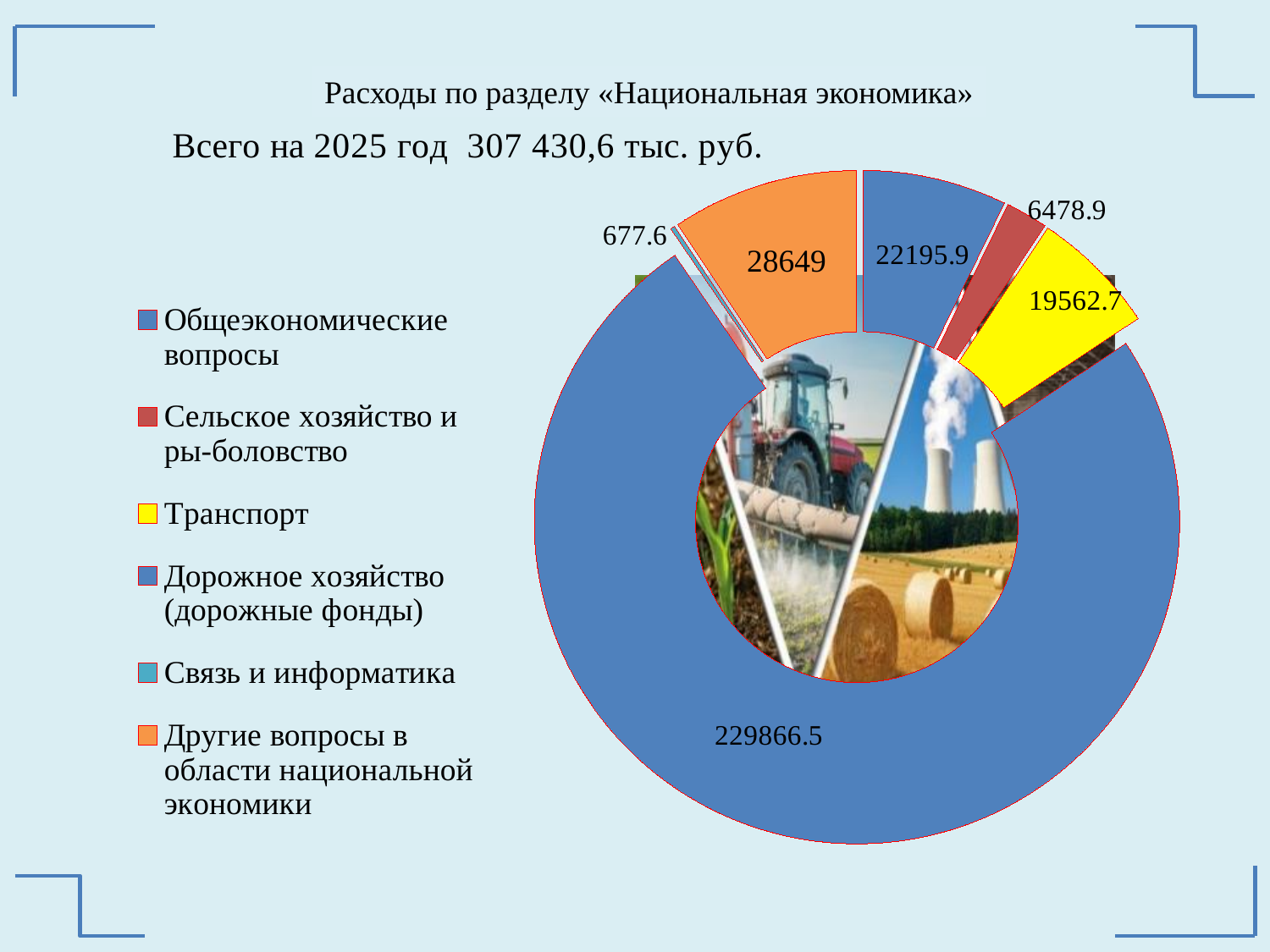
What kind of chart is shown on the slide? Pie (doughnut) chart What is the value shown for Другие вопросы в области национальной экономики? 28649 What total for 2025 is stated on the slide? 307 430,6 тыс. руб. What is the value shown for Дорожное хозяйство (дорожные фонды)? 229866.5 What is the value shown for Связь и информатика? 677.6 Which category has the smallest value in the chart? Связь и информатика How many categories are shown in the chart? 6 What is the value shown for Транспорт? 19562.7 Which is larger: the value for Общеэкономические вопросы or the value for Транспорт? Общеэкономические вопросы Which category has the largest value in the chart? Дорожное хозяйство (дорожные фонды) What is the difference between the values for Другие вопросы в области национальной экономики and Общеэкономические вопросы? 6453.1 What is the value shown for Сельское хозяйство и рыболовство? 6478.9